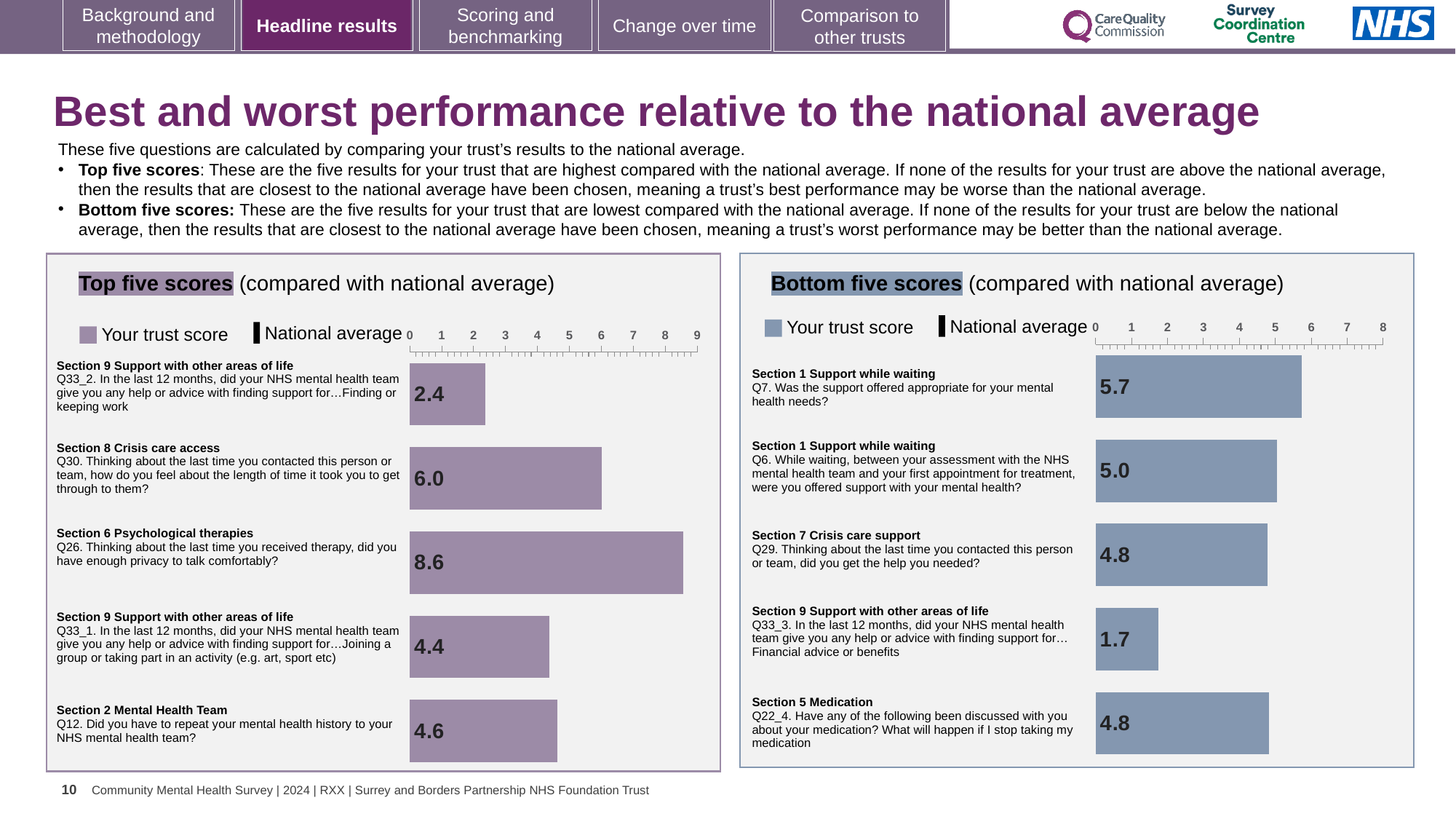
In the Bottom five scores chart, which question has the lowest trust score? Q33_3 In the Top five scores chart, what is the trust score for Q33_2 (help finding or keeping work)? 2.4 In the Top five scores chart, which question has the highest trust score? Q26 In the Top five scores chart, what is the trust score for Q26 (enough privacy to talk comfortably)? 8.6 In the Top five scores chart, which has the larger trust score, Q12 or Q33_1? Q12 In the Bottom five scores chart, what is the trust score for Q33_3 (help with financial advice or benefits)? 1.7 How many entries does the legend of the Bottom five scores chart list? 2 How many questions are shown in the Bottom five scores chart? 5 In the Top five scores chart, what is the difference between the trust scores for Q30 and Q33_1? 1.6 What kind of chart is the Top five scores chart? Bar chart In the Bottom five scores chart, what is the trust score for Q7 (was the support offered appropriate for your mental health needs)? 5.7 In the Bottom five scores chart, what is the difference between the trust scores for Q7 and Q6? 0.7